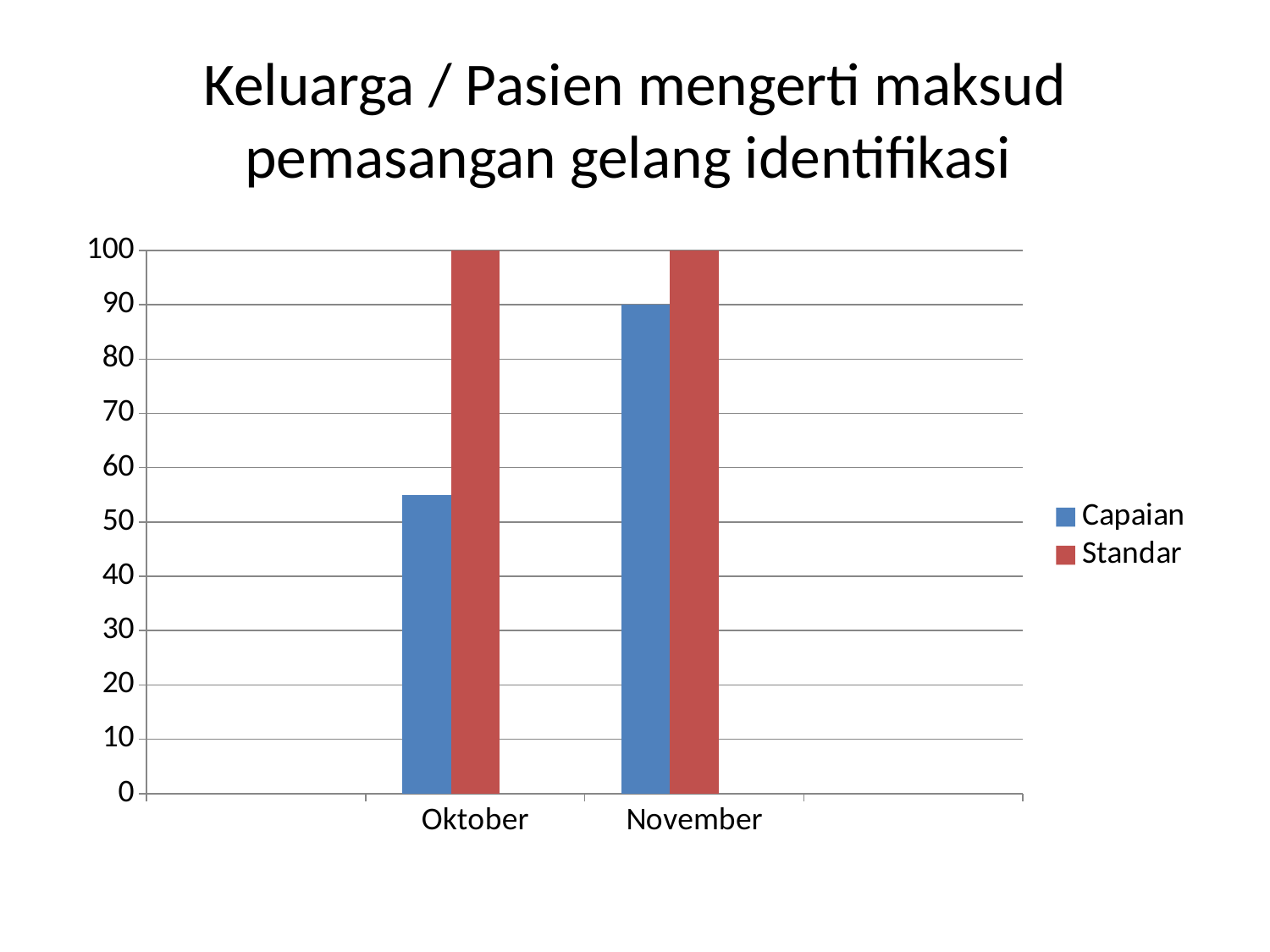
Which month has the larger Capaian value, Oktober or November? November Does the Capaian value rise or fall from Oktober to November? rises What is the Capaian value for November? 90 What kind of chart is shown on the slide? bar chart Which month has the lowest Capaian value? Oktober What is the difference between the Standar and Capaian values for November? 10 How many series does the legend list? 2 Is the Capaian value for Oktober greater or less than 60? less Is the Capaian value for Oktober greater or less than 50? greater What are the two entries listed in the legend? Capaian, Standar What is the Standar value for Oktober? 100 How many categories are shown on the x axis? 2